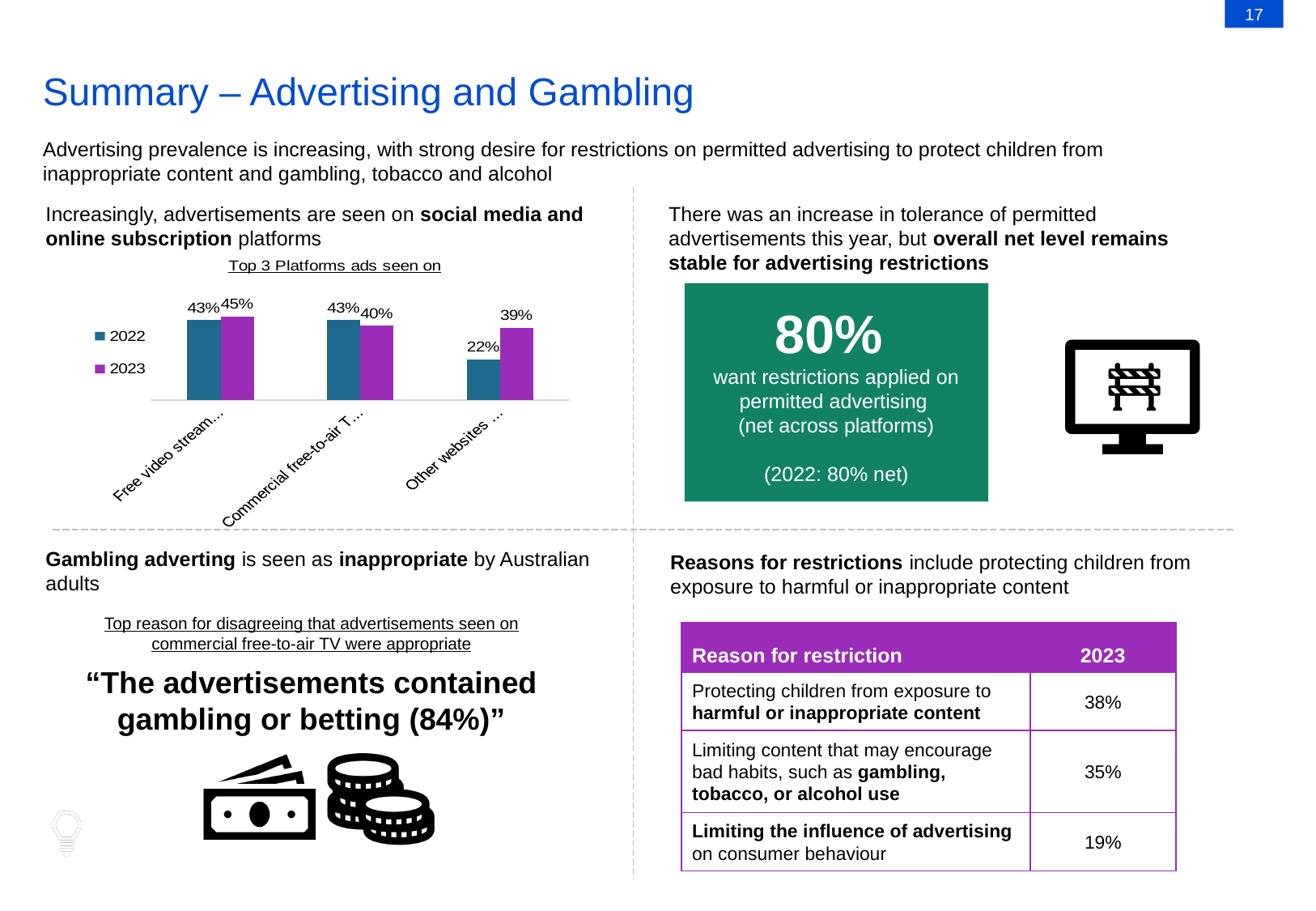
What kind of chart is 'Top 3 Platforms ads seen on'? Bar chart In the 'Top 3 Platforms ads seen on' chart, what is the difference between the 2023 and 2022 values for 'Other websites ...'? 17% In the 'Top 3 Platforms ads seen on' chart, is the 2022 or the 2023 value larger for 'Commercial free-to-air T...'? 2022 In the 'Top 3 Platforms ads seen on' chart, which colour represents the 2023 series? Purple In the 'Top 3 Platforms ads seen on' chart, what is the 2022 value for the 'Other websites ...' category? 22% How many series does the legend of the 'Top 3 Platforms ads seen on' chart list? 2 In the 'Top 3 Platforms ads seen on' chart, what is the difference between the 2022 and 2023 values for 'Commercial free-to-air T...'? 3% In the 'Top 3 Platforms ads seen on' chart, how many categories are shown on the x axis? 3 In the 'Top 3 Platforms ads seen on' chart, which category has the lowest 2022 value? Other websites ... In the 'Top 3 Platforms ads seen on' chart, which category has the highest 2023 value? Free video stream... In the 'Top 3 Platforms ads seen on' chart, what is the 2023 value for the 'Free video stream...' category? 45% In the 'Top 3 Platforms ads seen on' chart, what is the 2023 value for the 'Commercial free-to-air T...' category? 40%